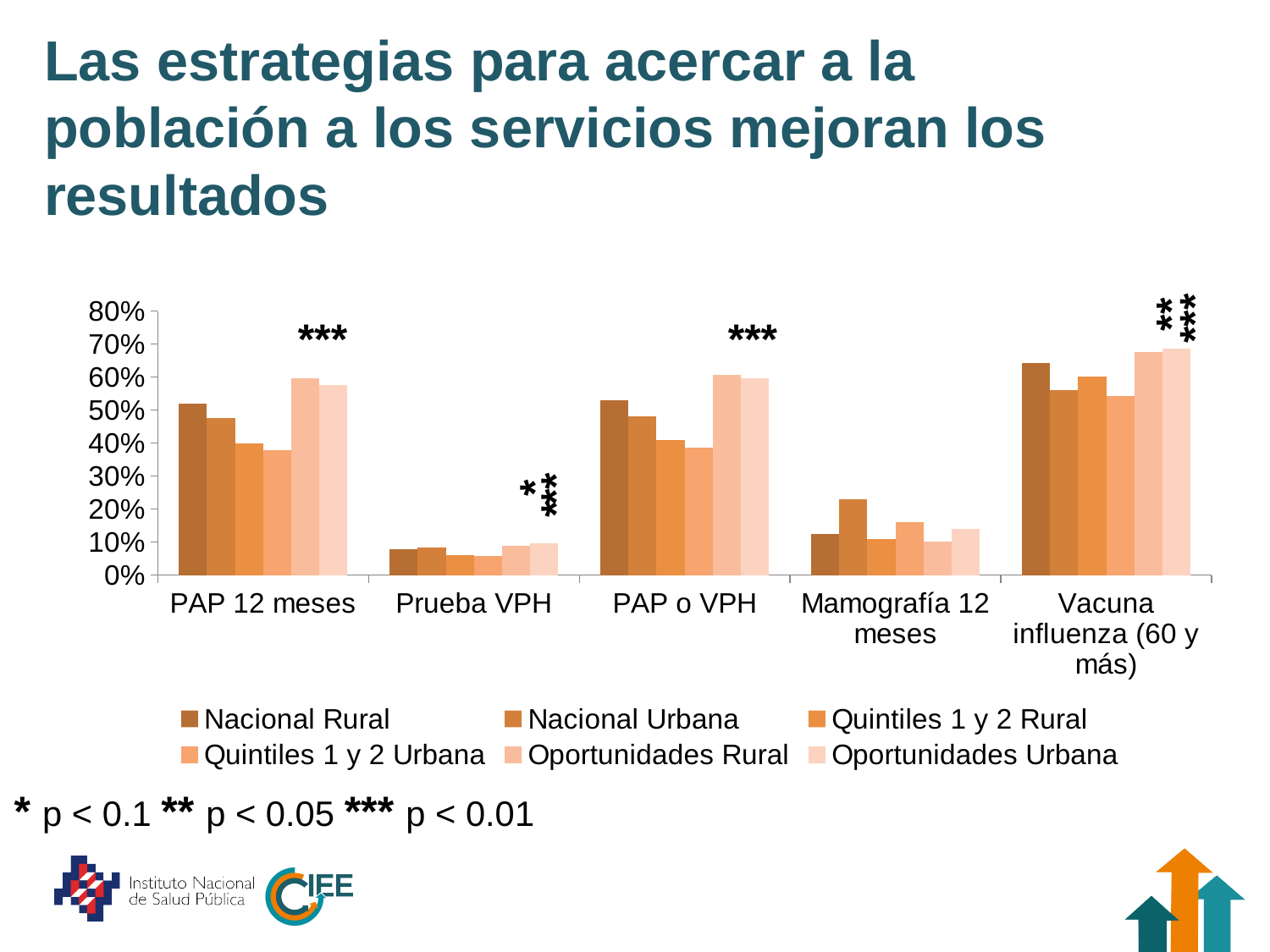
Is the value for Nacional Rural in the Prueba VPH category greater or less than 20%? less How many series does the chart's legend list? 6 Is the value for Oportunidades Rural in the PAP 12 meses category greater or less than 50%? greater In the Mamografía 12 meses category, which is larger: Nacional Rural or Nacional Urbana? Nacional Urbana What kind of chart is shown on the slide? bar chart In which category does the Nacional Rural series reach its highest value? Vacuna influenza (60 y más) In the PAP o VPH category, which is larger: Nacional Rural or Quintiles 1 y 2 Urbana? Nacional Rural Is the value for Nacional Urbana in the Mamografía 12 meses category greater or less than 30%? less How many categories are shown along the x axis of the chart? 5 Which category has the lowest values across all series? Prueba VPH